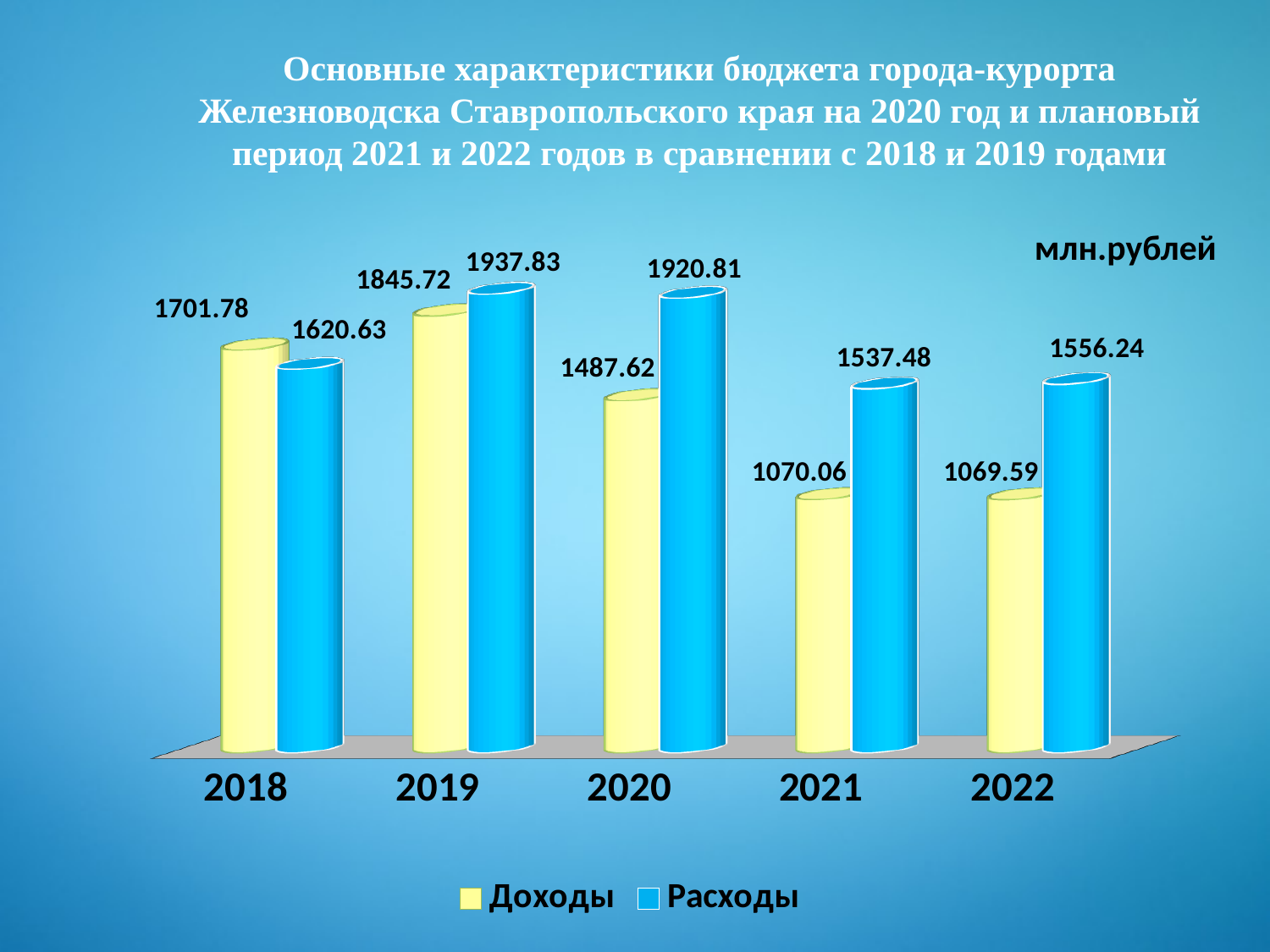
How many years are shown on the x axis? 5 What is the difference between Расходы and Доходы in 2019? 92.11 What is the value of Расходы for 2020? 1920.81 In 2021, which is larger: Доходы or Расходы? Расходы What kind of chart is shown on the slide? Bar chart In 2018, which is larger: Доходы or Расходы? Доходы What is the value of Доходы for 2018? 1701.78 What is the value of Расходы for 2022? 1556.24 In which year is Доходы the highest? 2019 What is the difference between Расходы and Доходы in 2020? 433.19 How many series does the legend list? 2 What is the value of Доходы for 2021? 1070.06